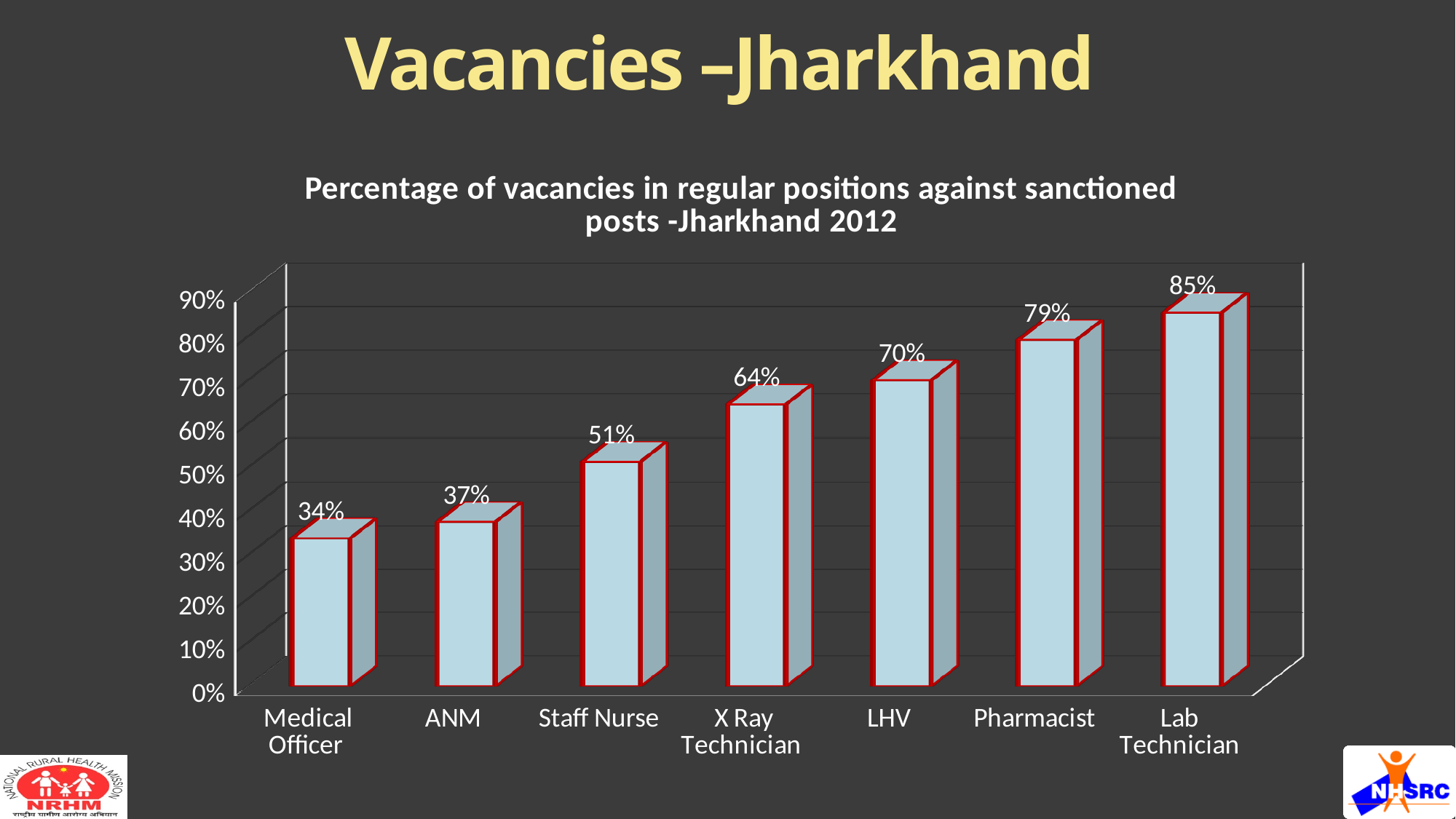
What is the percentage of vacancies for Medical Officer? 34% What is the difference between the vacancy percentages for LHV and Staff Nurse? 19% Which position has the highest percentage of vacancies? Lab Technician Do the vacancy percentages rise or fall from left to right across the positions? Rise What is the title of the chart? Percentage of vacancies in regular positions against sanctioned posts -Jharkhand 2012 What kind of chart is shown on the slide? Bar chart What is the difference between the vacancy percentages for Lab Technician and Medical Officer? 51% What is the percentage of vacancies for X Ray Technician? 64% Which has a higher vacancy percentage, ANM or Staff Nurse? Staff Nurse What is the percentage of vacancies for Pharmacist? 79% How many positions are shown on the chart? 7 Which position has the lowest percentage of vacancies? Medical Officer